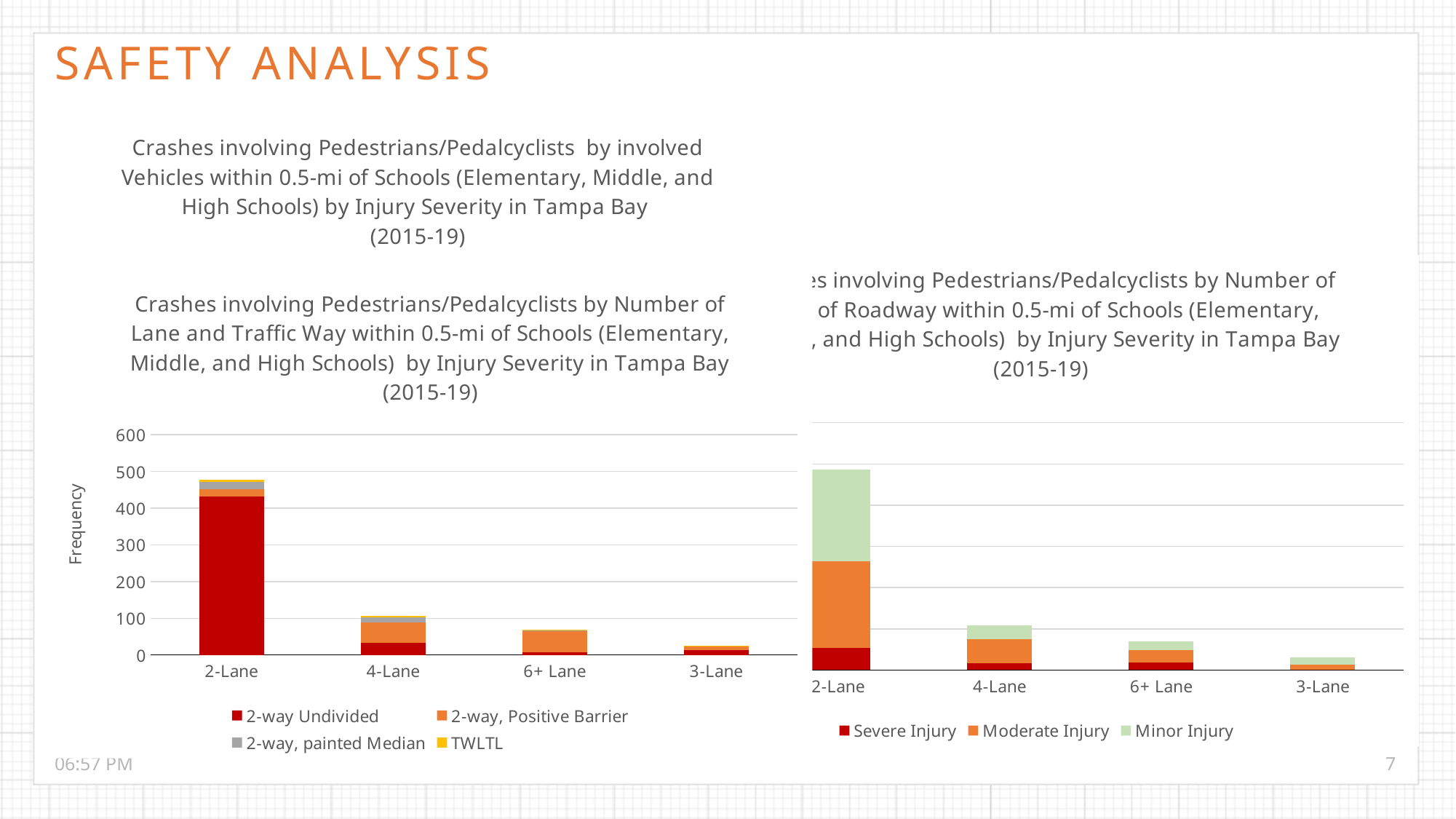
On the right chart (by Injury Severity), how many series does the legend list? 3 On the right chart (by Injury Severity), which lane category has the tallest stacked bar? 2-Lane On the left chart (Crashes by Number of Lane and Traffic Way), how many series does the legend list? 4 On the left chart (Crashes by Number of Lane and Traffic Way), is the total for 6+ Lane greater or less than 100? less On the left chart (Crashes by Number of Lane and Traffic Way), what is the label on the vertical axis? Frequency On the left chart (Crashes by Number of Lane and Traffic Way), which lane category has the tallest stacked bar? 2-Lane On the left chart (Crashes by Number of Lane and Traffic Way), which has the larger total, 4-Lane or 6+ Lane? 4-Lane On the left chart (Crashes by Number of Lane and Traffic Way), which lane category has the shortest stacked bar? 3-Lane On the left chart (Crashes by Number of Lane and Traffic Way), how many lane categories are shown on the x axis? 4 On the left chart (Crashes by Number of Lane and Traffic Way), what kind of chart is shown? Stacked bar chart On the left chart (Crashes by Number of Lane and Traffic Way), is the total for 2-Lane greater or less than 400? greater On the right chart (by Injury Severity), which lane category has the shortest stacked bar? 3-Lane